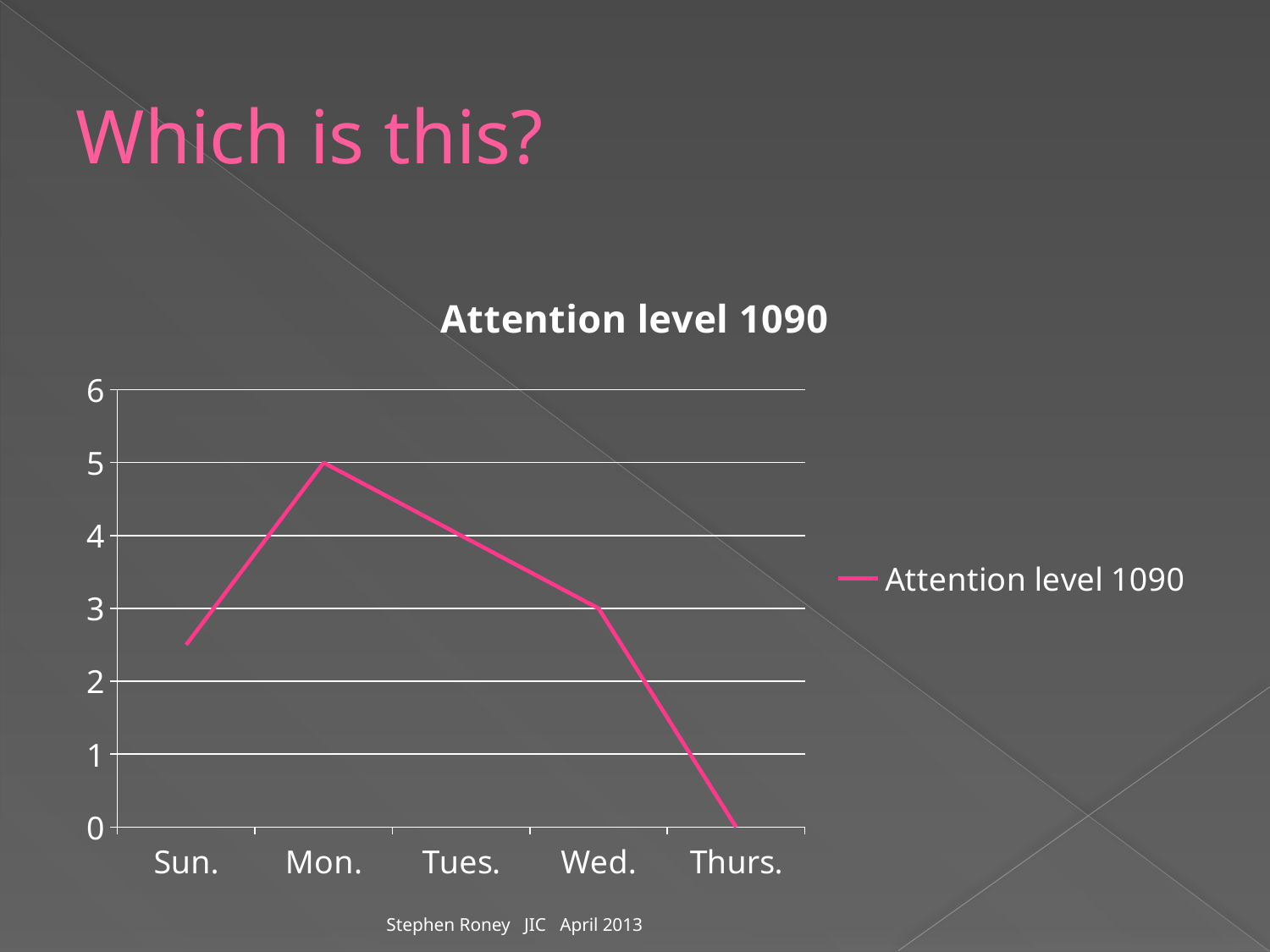
What is the difference between the attention level on Mon. and on Wed.? 2 What kind of chart is shown on the slide? line chart How many series does the legend list? 1 What is the attention level on Mon.? 5 What is the title of the chart? Attention level 1090 Does the attention level rise or fall from Mon. to Thurs.? fall How many days are plotted along the x axis? 5 What is the attention level on Wed.? 3 On which day is the attention level highest? Mon. Is the attention level on Sun. greater or less than 2? greater What is the attention level on Thurs.? 0 On which day is the attention level lowest? Thurs.